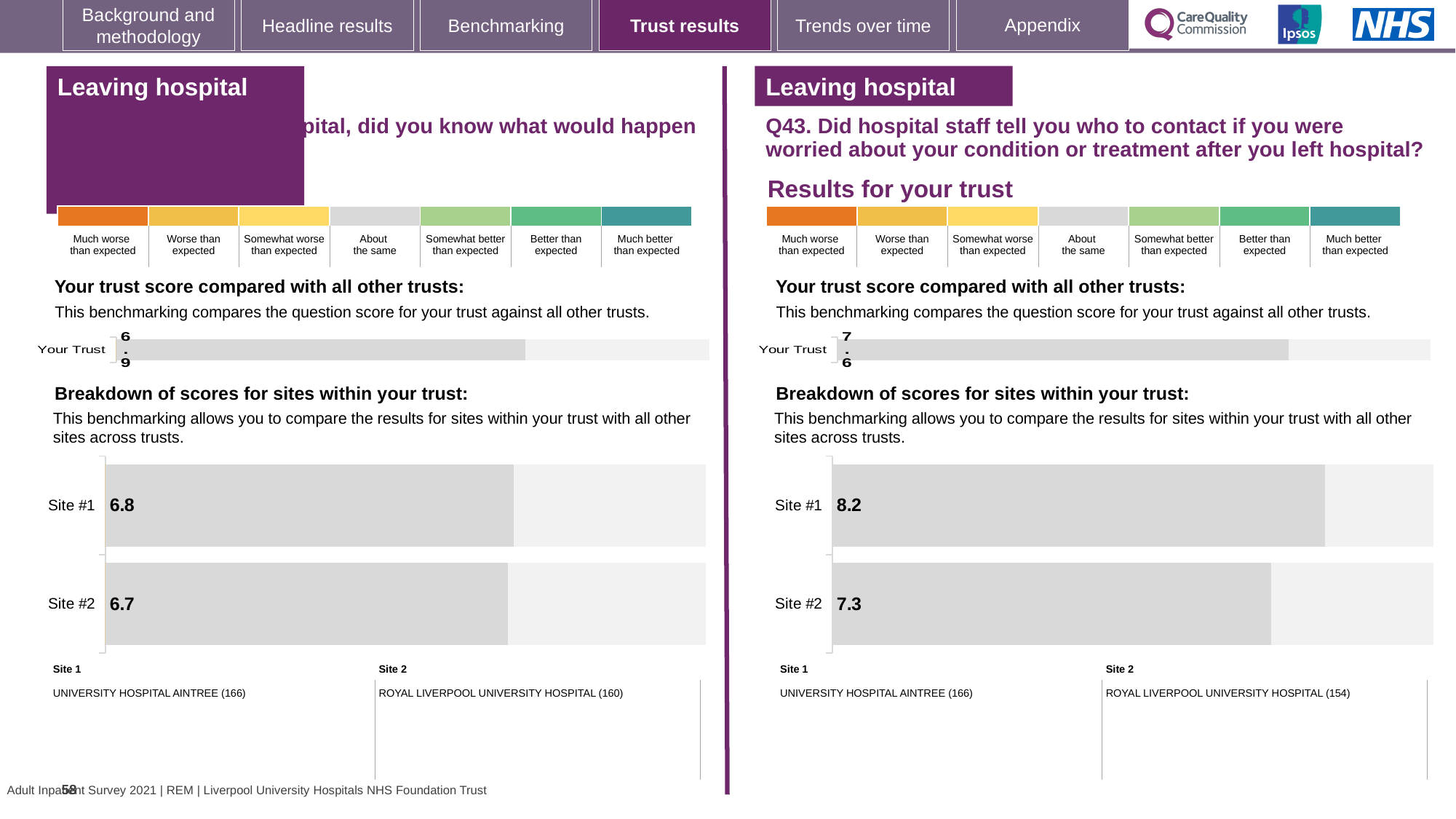
On the left-hand site breakdown chart, what is the difference between the Site #1 and Site #2 scores? 0.1 On the right-hand (Q43) 'Your trust score compared with all other trusts' chart, what is the value shown for Your Trust? 7.6 On the right-hand (Q43) site breakdown chart, what is the score for Site #2? 7.3 How many sites are shown on the right-hand (Q43) site breakdown chart? 2 On the right-hand (Q43) site breakdown chart, what is the difference between the Site #1 and Site #2 scores? 0.9 On the left-hand site breakdown chart, what is the score for Site #2? 6.7 On the right-hand (Q43) side, which hospital is listed as Site 2? ROYAL LIVERPOOL UNIVERSITY HOSPITAL (154) On the left-hand site breakdown chart, what is the score for Site #1? 6.8 On the right-hand (Q43) site breakdown chart, which site has the higher score? Site #1 On the left-hand 'Your trust score compared with all other trusts' chart, what is the value shown for Your Trust? 6.9 On the right-hand (Q43) site breakdown chart, what is the score for Site #1? 8.2 What type of chart is used for the site breakdown on the right-hand (Q43) side of the slide? Bar chart